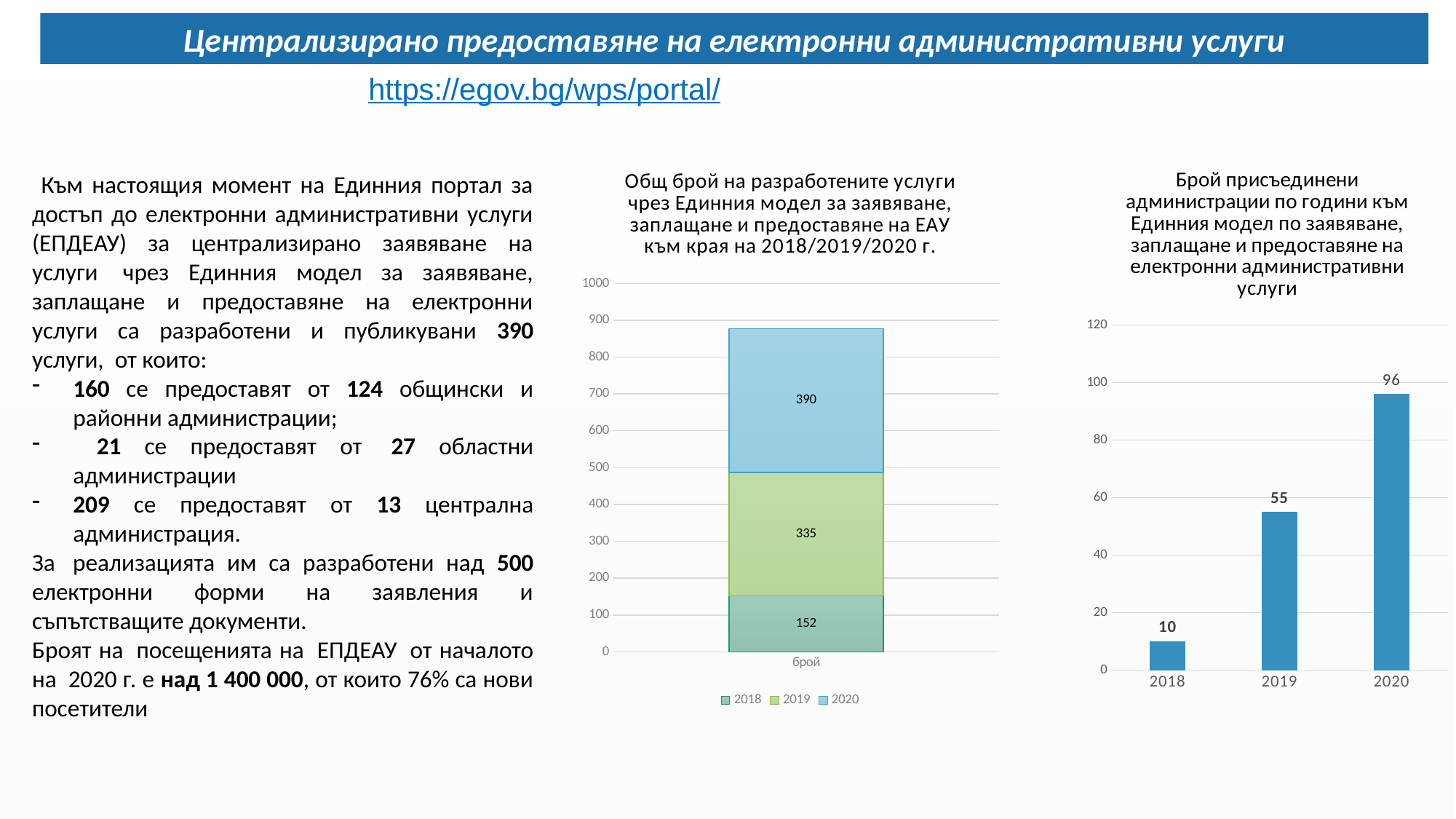
In the middle stacked bar chart, how many series does the legend list? 3 In the middle stacked bar chart, which series has the largest value? 2020 What kind of chart is the chart on the right? bar chart In the middle stacked bar chart, what is the value for the 2018 series? 152 In the bar chart on the right, what is the difference between the values for 2020 and 2018? 86 In the middle stacked bar chart, what is the value for the 2020 series? 390 In the bar chart on the right, what is the value for 2019? 55 In the bar chart on the right, how many years are shown on the x axis? 3 In the middle stacked bar chart, what is the total of the stacked bar? 877 In the bar chart on the right, which year has the lowest value? 2018 In the bar chart on the right, do the values rise or fall from 2018 to 2020? rise In the middle stacked bar chart, what is the difference between the 2019 and 2018 values? 183